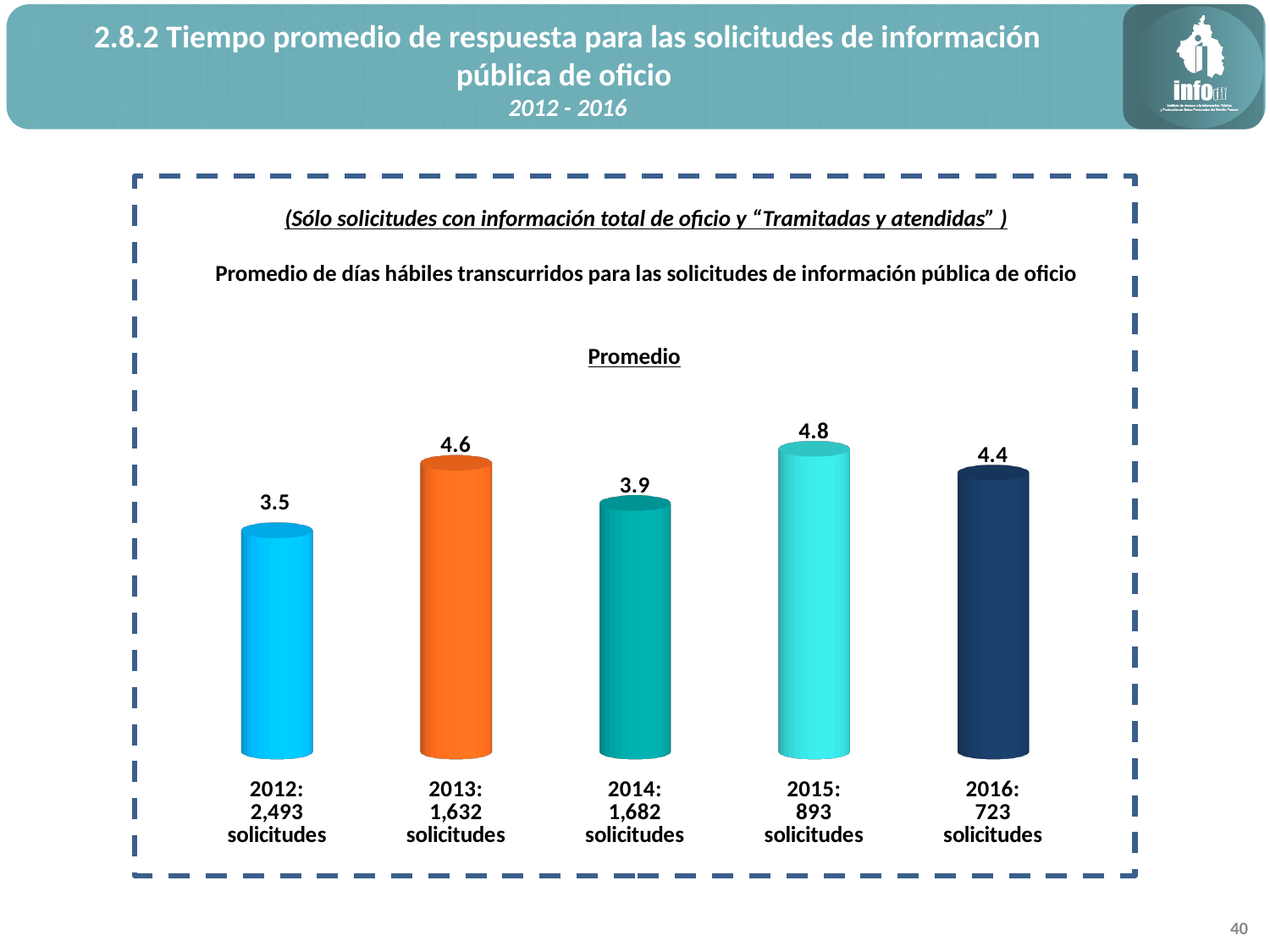
What is the difference between the average values for 2013 and 2014? 0.7 Which year has the lowest average value? 2012 How many solicitudes are listed under the 2014 bar? 1,682 solicitudes How many years are shown in the chart? 5 Which is larger, the average value for 2013 or for 2016? 2013 What is the average value shown for 2016? 4.4 Which year has the highest average value? 2015 What is the difference between the average values for 2015 and 2012? 1.3 What kind of chart is shown on the slide? Bar chart What is the title shown directly above the bars? Promedio What is the average value shown for 2012? 3.5 What is the average value shown for 2015? 4.8